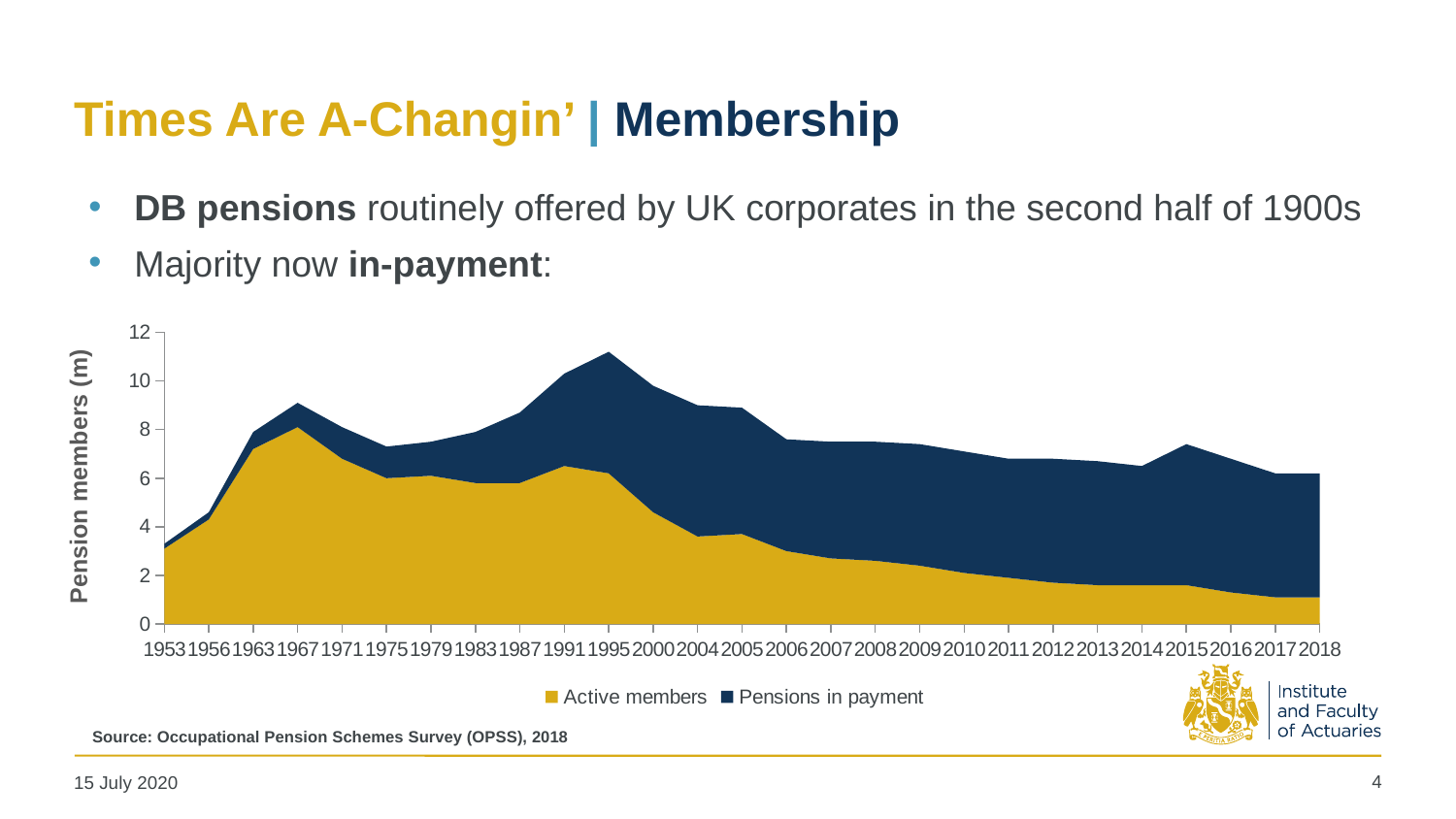
What are the two series named in the chart's legend? Active members; Pensions in payment Is the number of active members in 1953 greater or less than 2? greater How many series does the chart's legend list? 2 How many years are plotted along the x axis of the chart? 27 Is the number of active members in 2018 greater or less than 2? less Do active members rise or fall between 1991 and 2018? Fall In which year does the total of active members and pensions in payment reach its highest point? 1995 What is the label on the chart's vertical axis? Pension members (m) In which year is the number of active members at its highest? 1967 What kind of chart is shown on the slide? Area chart Which is larger in 2018: active members or pensions in payment? Pensions in payment Is the total of active members and pensions in payment in 1995 greater or less than 10? greater